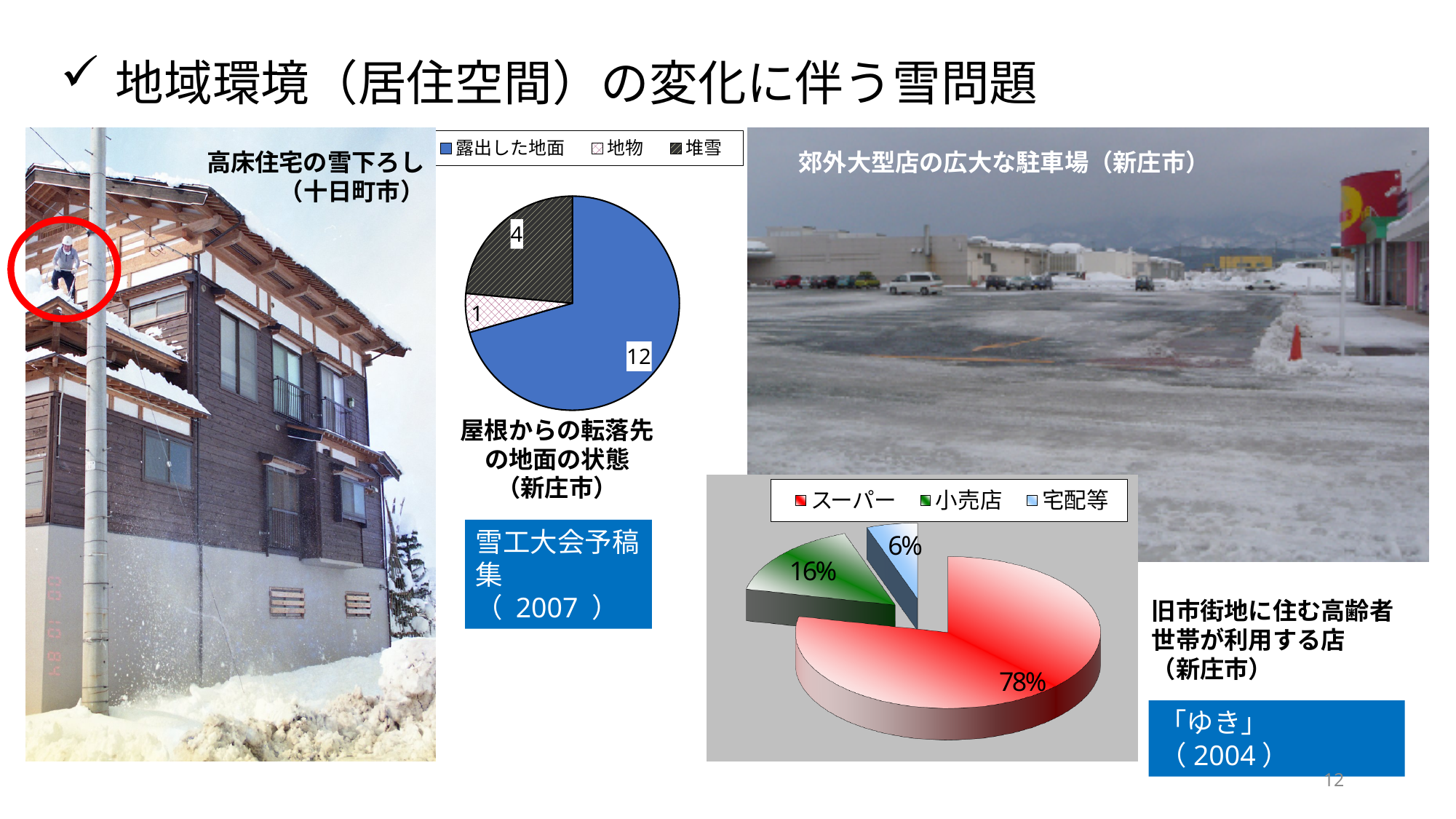
In the pie chart titled 屋根からの転落先の地面の状態（新庄市）, what is the difference between the values for 露出した地面 and 堆雪? 8 In the pie chart titled 屋根からの転落先の地面の状態（新庄市）, what is the value for 露出した地面? 12 In the pie chart titled 屋根からの転落先の地面の状態（新庄市）, which category has the largest value? 露出した地面 In the pie chart titled 旧市街地に住む高齢者世帯が利用する店（新庄市）, how many categories does the legend list? 3 In the pie chart titled 屋根からの転落先の地面の状態（新庄市）, which category has the smallest value? 地物 In the pie chart titled 屋根からの転落先の地面の状態（新庄市）, what is the value for 地物? 1 In the pie chart titled 屋根からの転落先の地面の状態（新庄市）, what is the value for 堆雪? 4 What kind of chart is the chart titled 旧市街地に住む高齢者世帯が利用する店（新庄市）? Pie chart In the pie chart titled 屋根からの転落先の地面の状態（新庄市）, what is the total of all three categories? 17 In the pie chart titled 旧市街地に住む高齢者世帯が利用する店（新庄市）, which category has the smallest share? 宅配等 In the pie chart titled 旧市街地に住む高齢者世帯が利用する店（新庄市）, what share is 小売店? 16% In the pie chart titled 旧市街地に住む高齢者世帯が利用する店（新庄市）, what share is スーパー? 78%